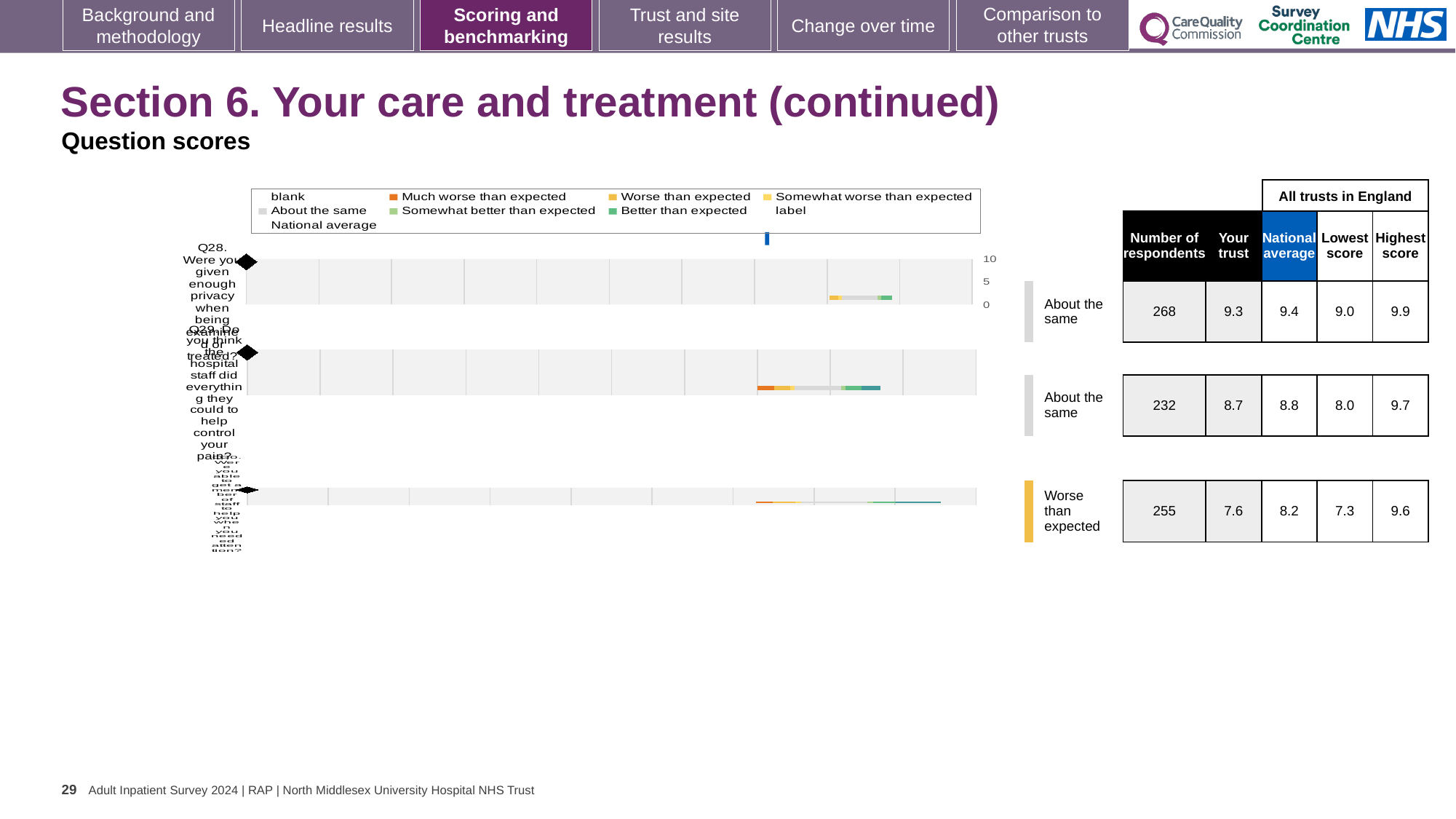
Which question has the highest trust score? Q28 What is the trust's score for Q30 (able to get a member of staff to help when needed)? 7.6 What kind of chart is used to show the question scores? bar chart What is the trust's score for Q28 (privacy when being examined or treated)? 9.3 How many questions (categories) are plotted on the chart? 3 Which question has the lowest trust score? Q30 What is the highest score among all trusts in England for Q28? 9.9 What is the national average score for Q29 (staff did everything to help control pain)? 8.8 Is the trust score for Q29 larger or smaller than the national average for Q29? smaller What benchmark category is Q30 rated as? Worse than expected What is the difference between the national average and the trust score for Q30? 0.6 How many respondents answered Q29? 232